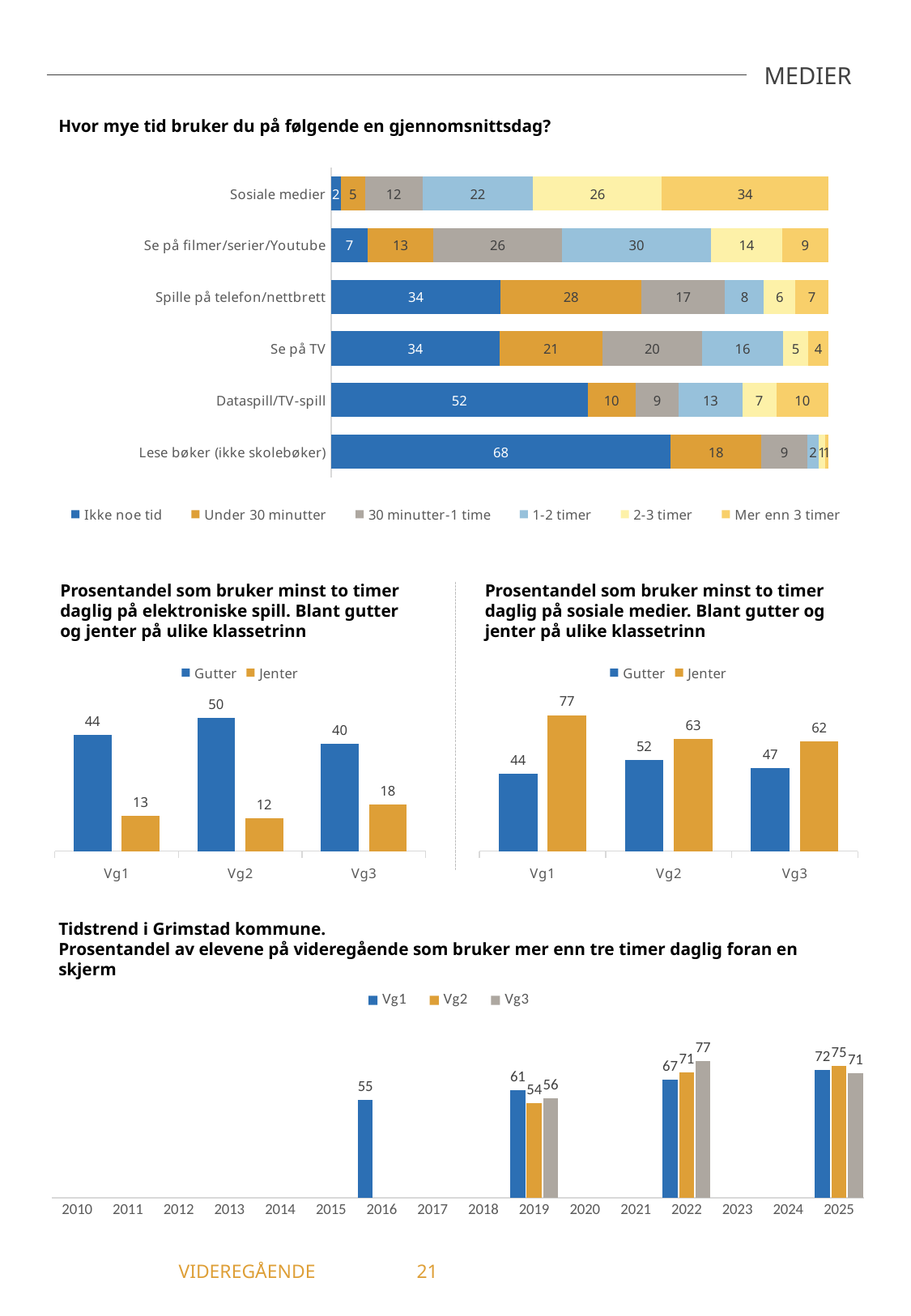
What kind of chart is the bottom chart 'Tidstrend i Grimstad kommune'? bar chart In the top chart 'Hvor mye tid bruker du på følgende en gjennomsnittsdag?', which category has the highest value for 'Ikke noe tid'? Lese bøker (ikke skolebøker) In the chart 'Prosentandel som bruker minst to timer daglig på sosiale medier', which group has the higher value at Vg1, Gutter or Jenter? Jenter In the top chart 'Hvor mye tid bruker du på følgende en gjennomsnittsdag?', what is the value for 'Mer enn 3 timer' for Sosiale medier? 34 In the bottom chart 'Tidstrend i Grimstad kommune', does the value for Vg1 rise or fall from 2016 to 2025? rise In the chart 'Prosentandel som bruker minst to timer daglig på sosiale medier', what is the value for Jenter at Vg3? 62 In the chart 'Prosentandel som bruker minst to timer daglig på elektroniske spill', what is the difference between Gutter and Jenter at Vg1? 31 In the top chart 'Hvor mye tid bruker du på følgende en gjennomsnittsdag?', how many series does the legend list? 6 In the chart 'Prosentandel som bruker minst to timer daglig på elektroniske spill', what is the value for Gutter at Vg2? 50 In the top chart 'Hvor mye tid bruker du på følgende en gjennomsnittsdag?', what is the value for '1-2 timer' for Se på filmer/serier/Youtube? 30 In the chart 'Prosentandel som bruker minst to timer daglig på sosiale medier', how many class levels are shown on the x axis? 3 In the bottom chart 'Tidstrend i Grimstad kommune', what is the value for Vg3 in 2022? 77